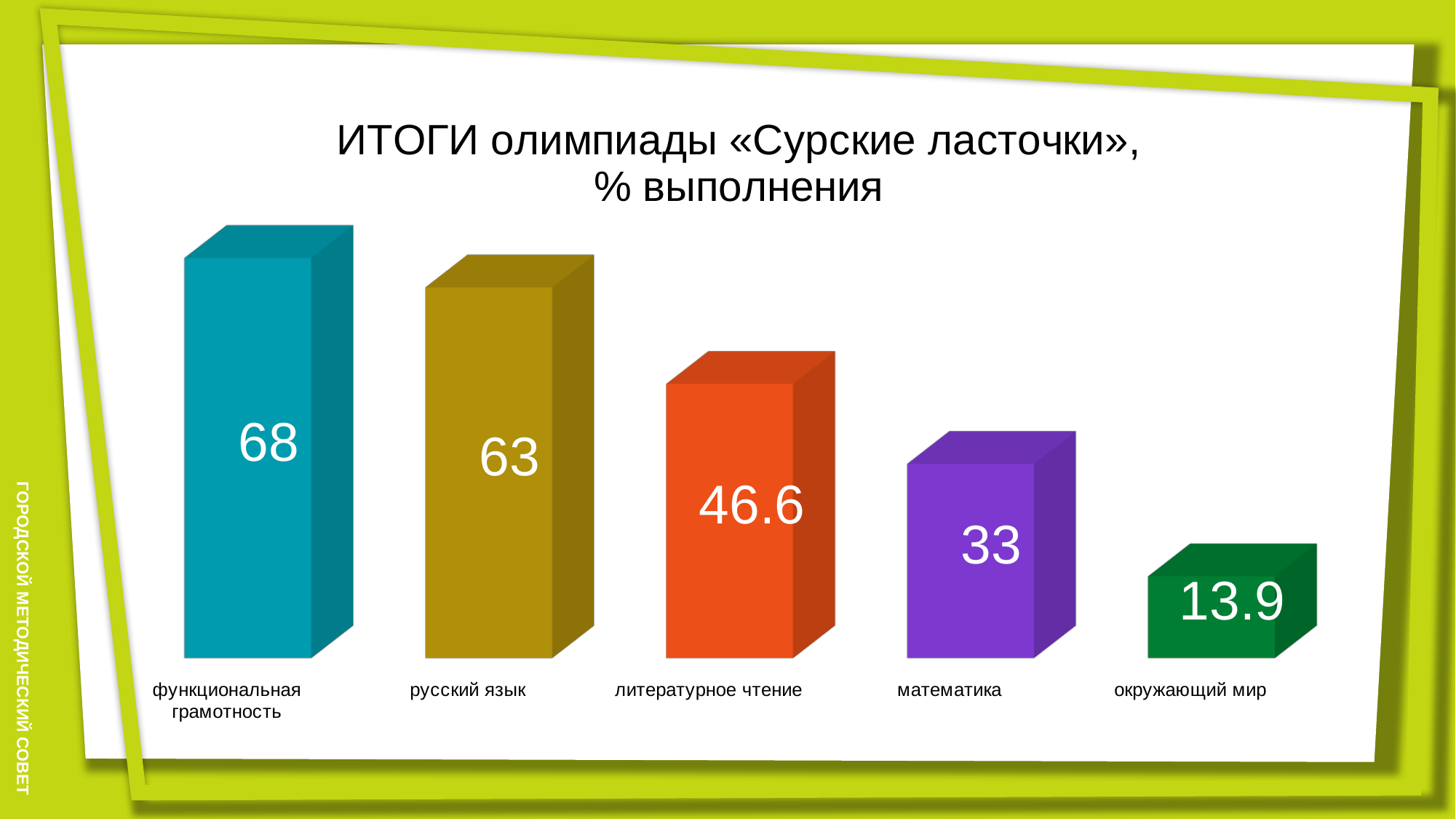
How many categories are shown in the chart? 5 What kind of chart is shown on the slide? bar chart What is the difference between the values for функциональная грамотность and русский язык? 5 What is the value for окружающий мир? 13.9 Which category has the highest value? функциональная грамотность What is the difference between the values for математика and окружающий мир? 19.1 What is the value for функциональная грамотность? 68 What is the value for литературное чтение? 46.6 Which category has the lowest value? окружающий мир What is the value for русский язык? 63 What is the value for математика? 33 Which is larger, the value for литературное чтение or the value for математика? литературное чтение